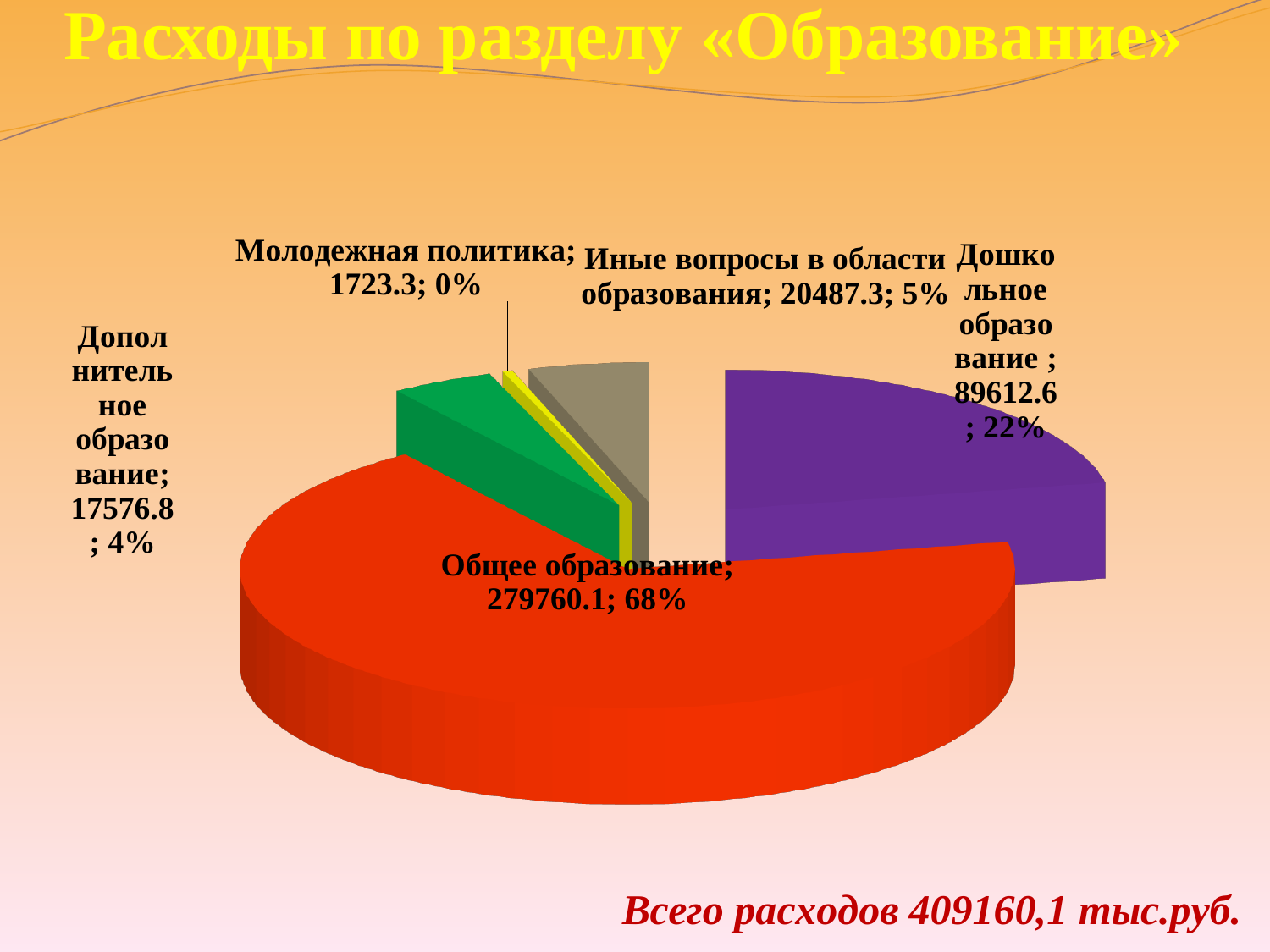
What is the value for Молодежная политика? 1723.3 What is the value for Иные вопросы в области образования? 20487.3 What is the value for Общее образование? 279760.1 What share of the pie does Общее образование have? 68% Which category has the smallest slice? Молодежная политика Which is larger, Дошкольное образование or Иные вопросы в области образования? Дошкольное образование What is the difference between the values for Иные вопросы в области образования and Дополнительное образование? 2910.5 What kind of chart is shown on the slide? Pie chart How many categories does the pie chart have? 5 What is the value for Дошкольное образование? 89612.6 What share of the pie does Дополнительное образование have? 4% Which category has the largest slice? Общее образование